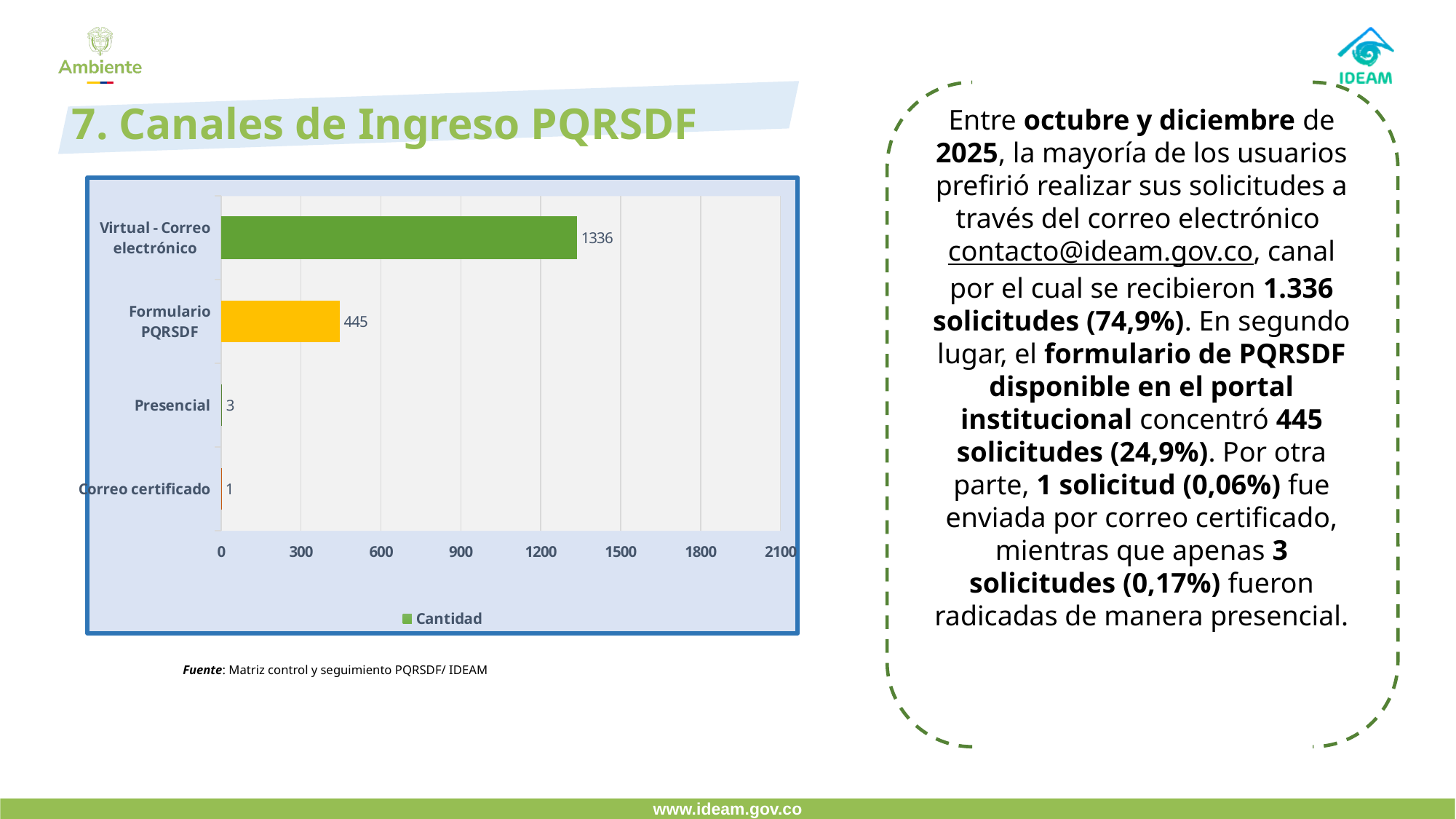
Is the value for Virtual - Correo electrónico greater or less than 1200? greater What is the value for Formulario PQRSDF? 445 What is the difference between the values for Virtual - Correo electrónico and Formulario PQRSDF? 891 Which is larger, the value for Presencial or the value for Correo certificado? Presencial What is the value for Correo certificado? 1 What series name does the legend show? Cantidad What is the value for Virtual - Correo electrónico? 1336 Which category has the highest value? Virtual - Correo electrónico Which category has the lowest value? Correo certificado What is the value for Presencial? 3 How many categories are shown in the chart? 4 What kind of chart is shown on the slide? Bar chart